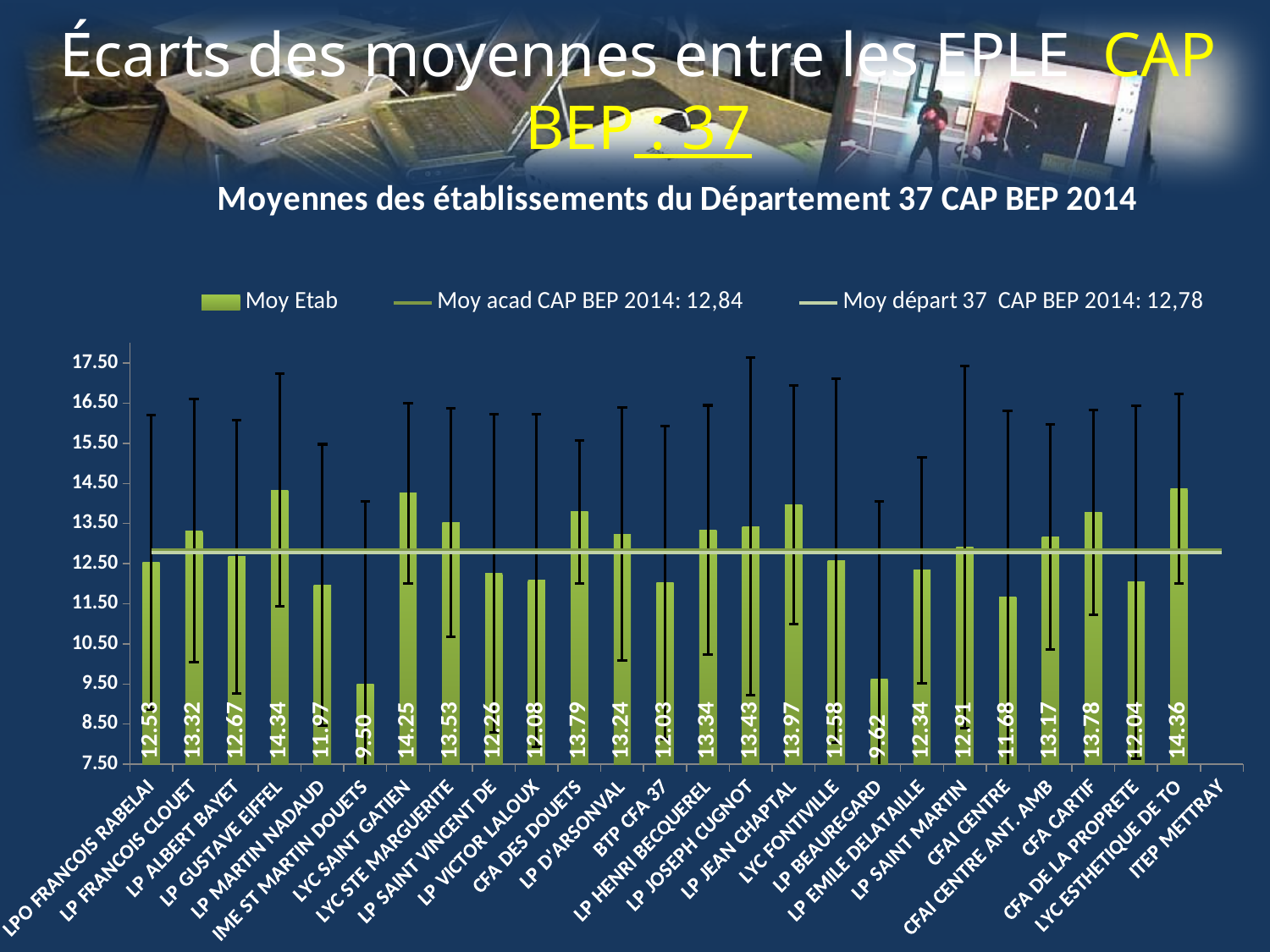
What is the Moy Etab value for CFA CARTIF? 13.78 How many series does the legend list? 3 Is the Moy Etab value for CFA DES DOUETS greater or less than 13.50? greater What is the Moy Etab value for LYC SAINT GATIEN? 14.25 What is the Moy Etab value for LP BEAUREGARD? 9.62 What type of chart is shown on the slide? bar chart Which establishment has the lowest Moy Etab value? IME ST MARTIN DOUETS What is the Moy Etab value for LP GUSTAVE EIFFEL? 14.34 What value does the legend give for Moy acad CAP BEP 2014? 12,84 What is the difference between the Moy Etab values of LP GUSTAVE EIFFEL and LP MARTIN NADAUD? 2.37 Which has a higher Moy Etab value, LP JEAN CHAPTAL or LYC FONTIVILLE? LP JEAN CHAPTAL What is the title of the chart? Moyennes des établissements du Département 37 CAP BEP 2014